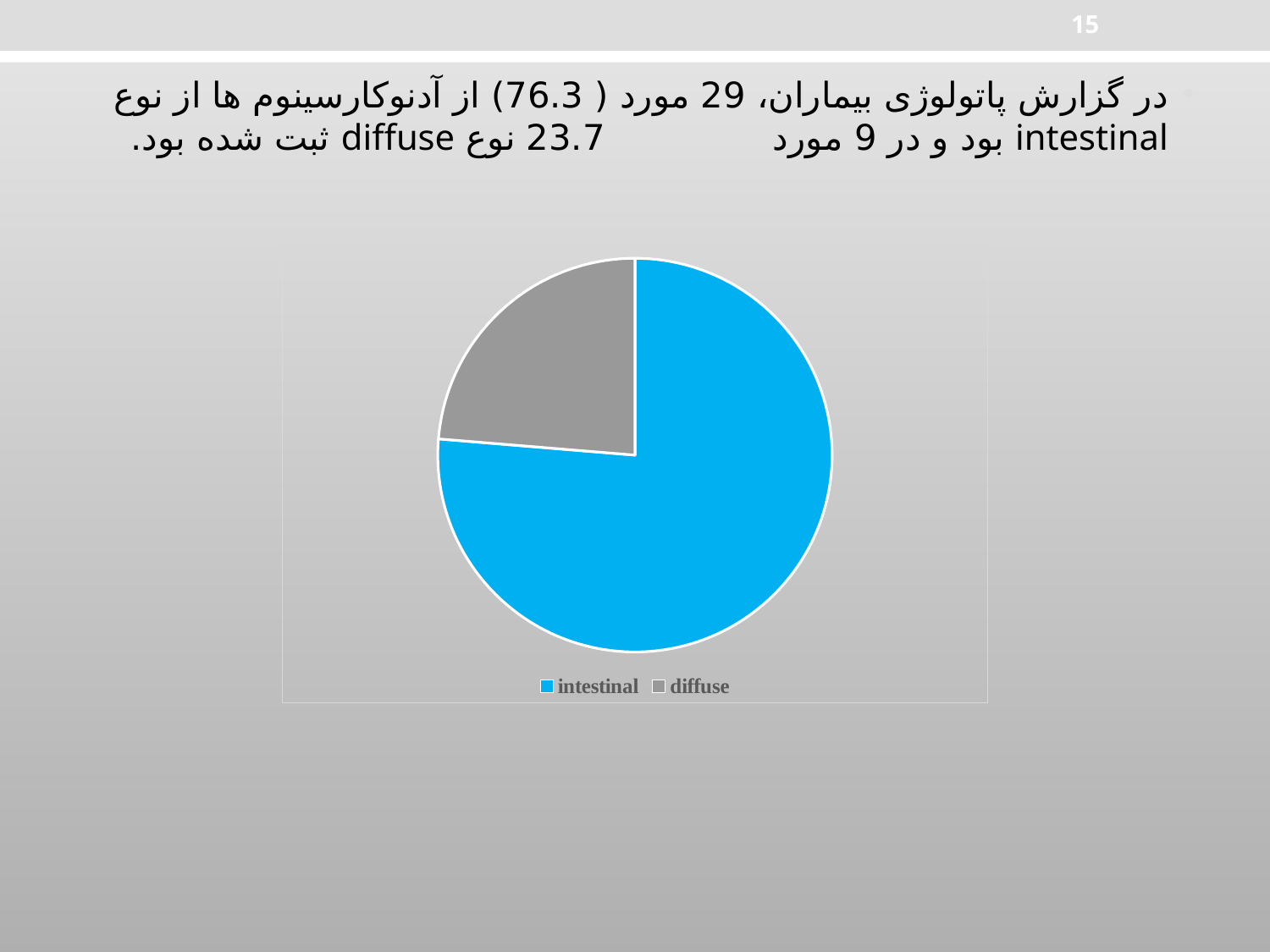
According to the slide text, what percentage of cases were of the intestinal type? 76.3 According to the slide text, how many cases were of the diffuse type? 9 What colour is the diffuse slice in the pie chart? gray How many entries does the legend of the pie chart list? 2 Which category has the largest slice in the pie chart? intestinal What kind of chart is shown on the slide? pie chart What colour is the intestinal slice in the pie chart? blue How many slices does the pie chart have? 2 According to the slide text, how many cases were of the intestinal type? 29 Which slice is larger in the pie chart, intestinal or diffuse? intestinal Which category has the smallest slice in the pie chart? diffuse According to the slide text, what percentage of cases were of the diffuse type? 23.7